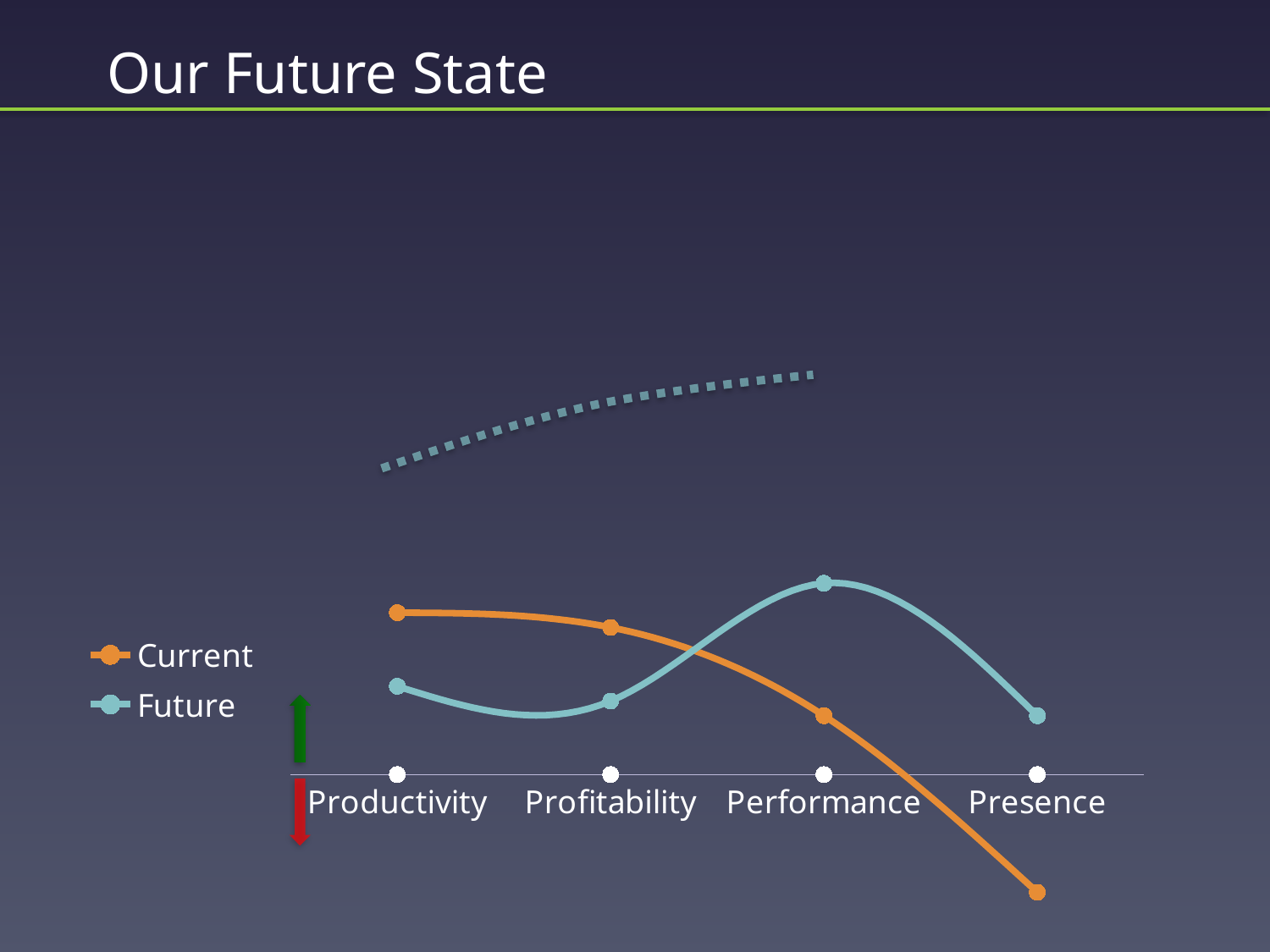
Which category has the lowest value for the Current series? Presence What are the two series named in the chart's legend? Current and Future At Productivity, which series has the larger value, Current or Future? Current At Performance, which series has the larger value, Current or Future? Future Which category has the highest value for the Future series? Performance How many categories are shown on the x axis of the chart? 4 Do the values of the Current series rise or fall from Productivity to Presence? Fall Does the Future series rise or fall from Profitability to Performance? Rise What kind of chart is shown on the slide? Line chart Which category has the highest value for the Current series? Productivity At Presence, which series has the larger value, Current or Future? Future How many series does the chart's legend list? 2